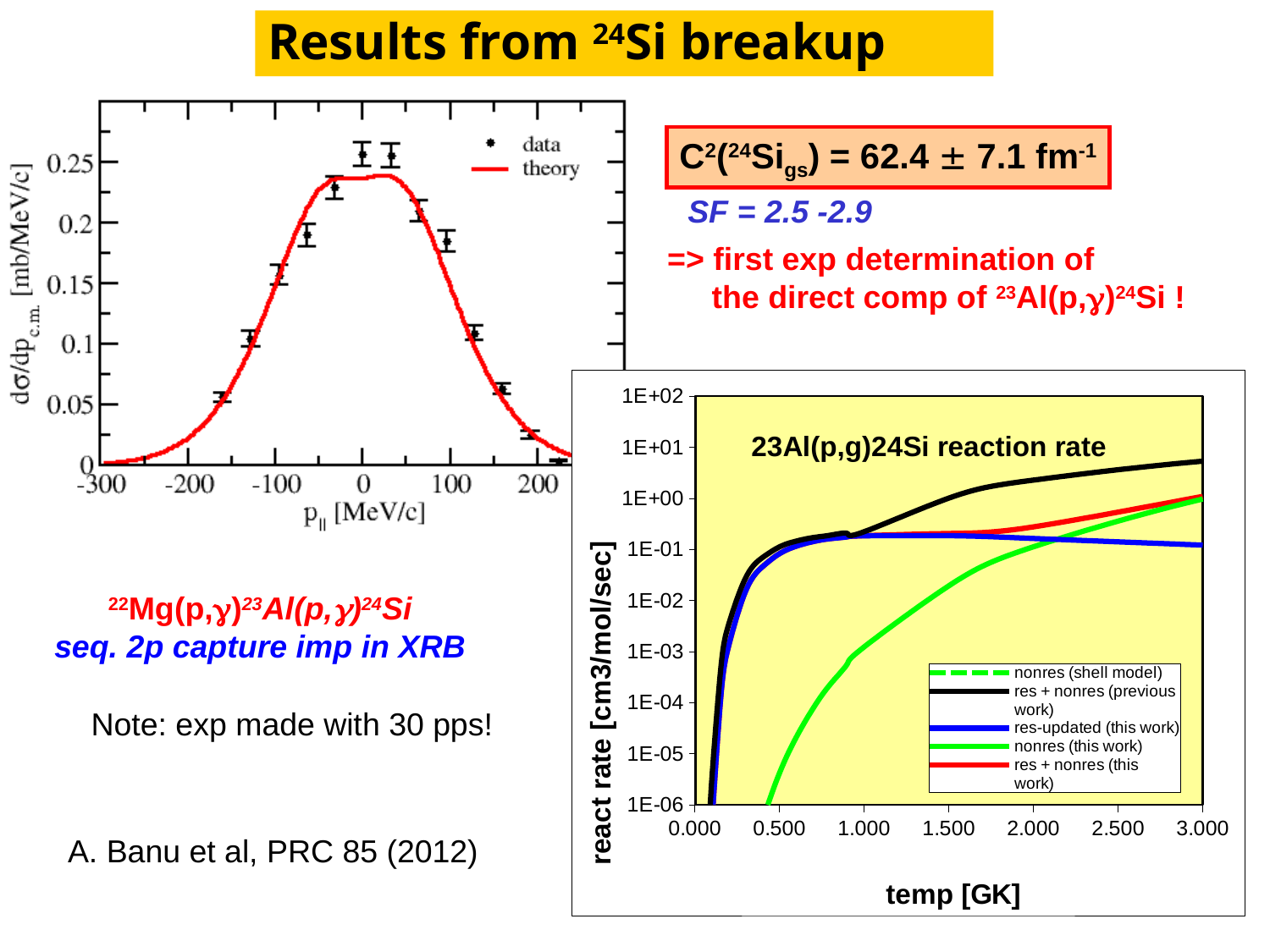
How many series does the legend of the '23Al(p,g)24Si reaction rate' chart list? 5 In the '23Al(p,g)24Si reaction rate' chart, is the 'res + nonres (this work)' value at 2.000 GK greater or less than 1E+00? less In the '23Al(p,g)24Si reaction rate' chart, at 3.000 GK, which is larger: 'res + nonres (previous work)' or 'res + nonres (this work)'? res + nonres (previous work) In the '23Al(p,g)24Si reaction rate' chart, is the 'res + nonres (previous work)' value at 3.000 GK greater or less than 1E+00? greater What kind of chart is the '23Al(p,g)24Si reaction rate' chart? line chart In the top-left momentum distribution chart, is the data value at p_|| = 100 MeV/c greater or less than 0.15? greater In the top-left momentum distribution chart, how many series does the legend list? 2 In the '23Al(p,g)24Si reaction rate' chart, what colour is the 'res-updated (this work)' line? blue In the '23Al(p,g)24Si reaction rate' chart, what is the label of the x axis? temp [GK] In the '23Al(p,g)24Si reaction rate' chart, does the 'nonres (this work)' line rise or fall as temperature increases? rise In the '23Al(p,g)24Si reaction rate' chart, at 1.000 GK, which is larger: 'res-updated (this work)' or 'nonres (this work)'? res-updated (this work)